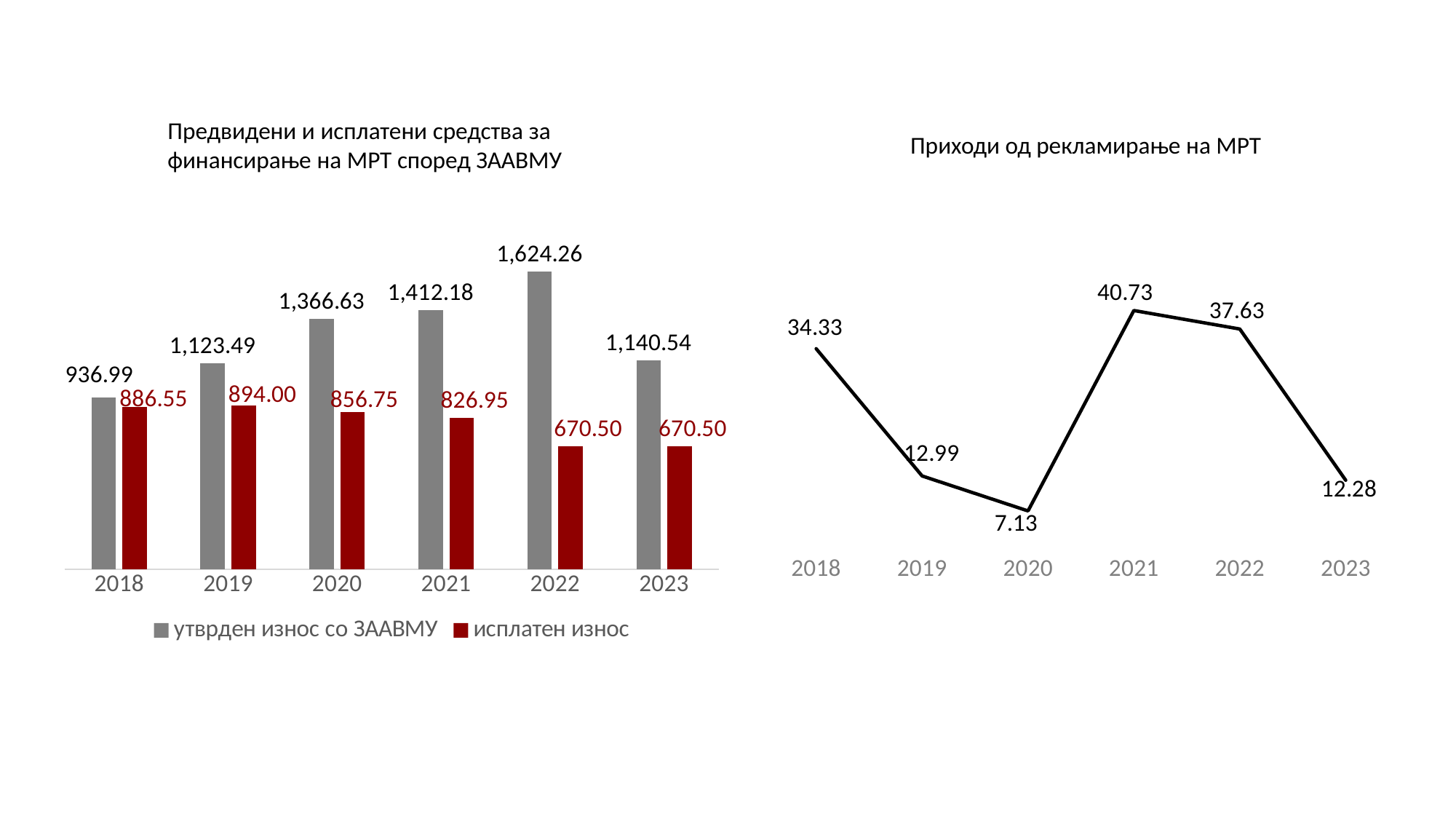
In the left chart 'Предвидени и исплатени средства за финансирање на МРТ според ЗААВМУ', which year has the lowest 'утврден износ со ЗААВМУ'? 2018 What type of chart is the right chart 'Приходи од рекламирање на МРТ'? Line chart In the left chart 'Предвидени и исплатени средства за финансирање на МРТ според ЗААВМУ', which year has the highest 'утврден износ со ЗААВМУ'? 2022 In the right chart 'Приходи од рекламирање на МРТ', how many data points are plotted? 6 What type of chart is the left chart 'Предвидени и исплатени средства за финансирање на МРТ според ЗААВМУ'? Bar chart In the right chart 'Приходи од рекламирање на МРТ', is the value for 2018 or 2022 larger? 2022 In the left chart 'Предвидени и исплатени средства за финансирање на МРТ според ЗААВМУ', what is the value of 'утврден износ со ЗААВМУ' for 2020? 1,366.63 In the right chart 'Приходи од рекламирање на МРТ', which year has the lowest value? 2020 In the right chart 'Приходи од рекламирање на МРТ', what is the value for 2021? 40.73 In the left chart 'Предвидени и исплатени средства за финансирање на МРТ според ЗААВМУ', what is the difference between 'утврден износ со ЗААВМУ' and 'исплатен износ' in 2022? 953.76 In the left chart 'Предвидени и исплатени средства за финансирање на МРТ според ЗААВМУ', how many series does the legend list? 2 In the left chart 'Предвидени и исплатени средства за финансирање на МРТ според ЗААВМУ', what is the value of 'исплатен износ' for 2019? 894.00